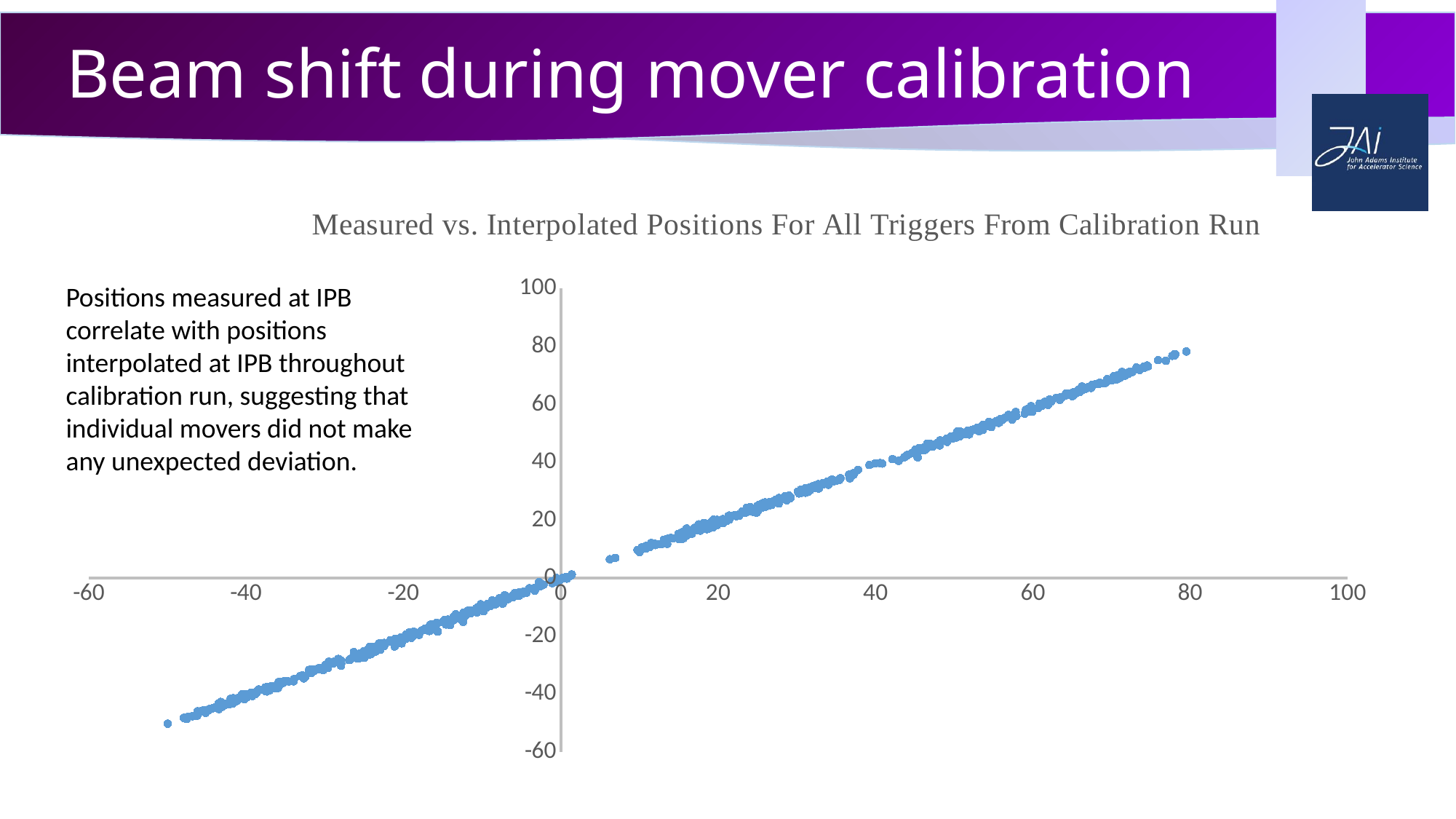
Is the highest plotted y value greater or less than 60? greater Is the smallest plotted x value greater or less than -40? less What kind of chart is shown on the slide? scatter chart Is the lowest plotted y value greater or less than -40? less What is the highest tick label shown on the x axis? 100 Do the plotted values rise or fall as the x-axis value increases? rise What is the title of the chart? Measured vs. Interpolated Positions For All Triggers From Calibration Run